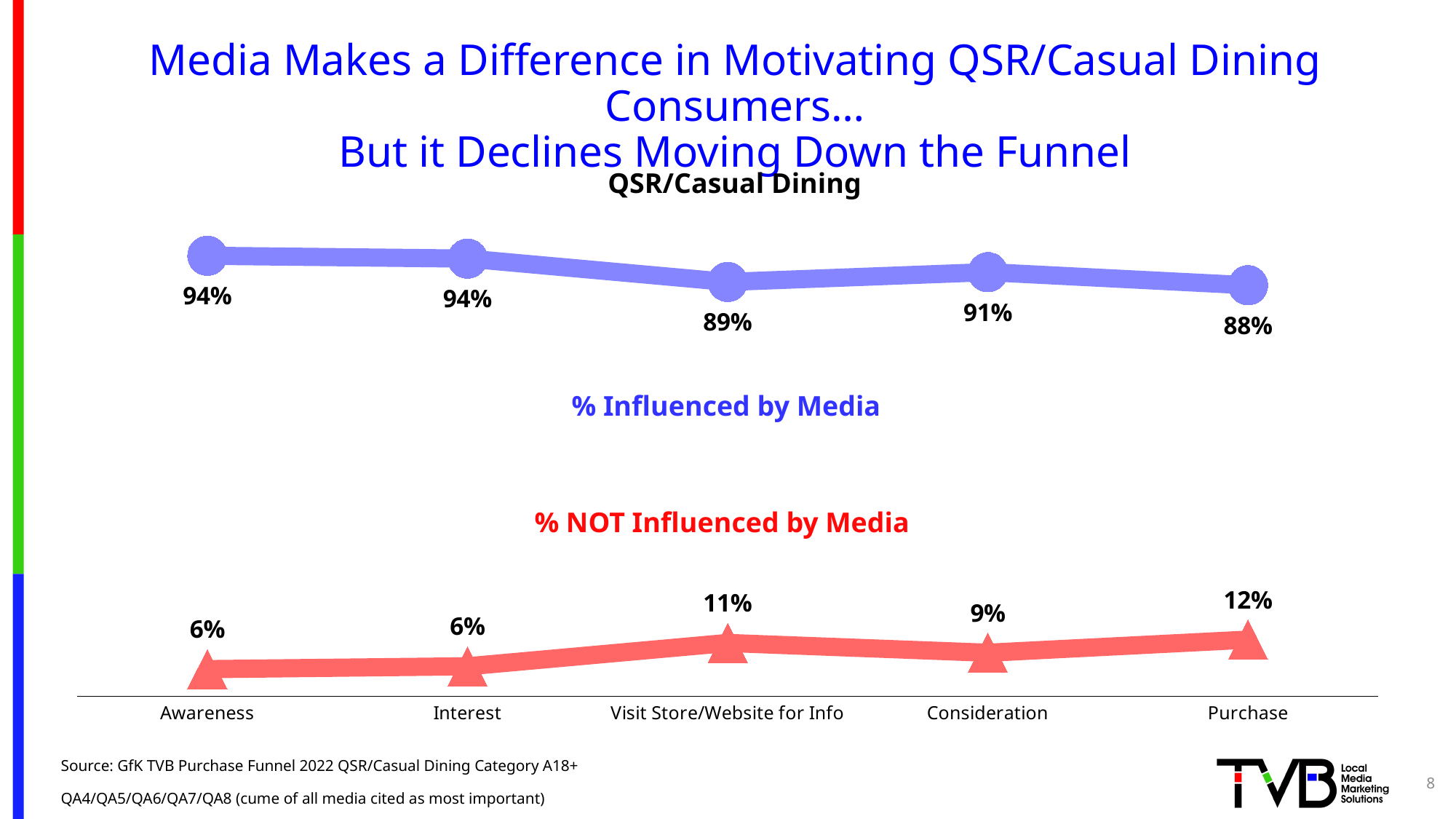
What is the % Influenced by Media value for Awareness? 94% Which is larger: the % Influenced by Media value for Interest or for Consideration? Interest Which funnel stage has the lowest % Influenced by Media value? Purchase Which funnel stage has the highest % NOT Influenced by Media value? Purchase Does the % NOT Influenced by Media series generally rise or fall moving from Awareness to Purchase? Rise How many data series are plotted on the chart? 2 What is the % NOT Influenced by Media value for Consideration? 9% What type of chart is shown on the slide? Line chart What is the difference between the % Influenced by Media values for Awareness and Purchase? 6 percentage points What is the % NOT Influenced by Media value for Purchase? 12% What is the % Influenced by Media value for Visit Store/Website for Info? 89% How many funnel stages are shown on the x axis? 5